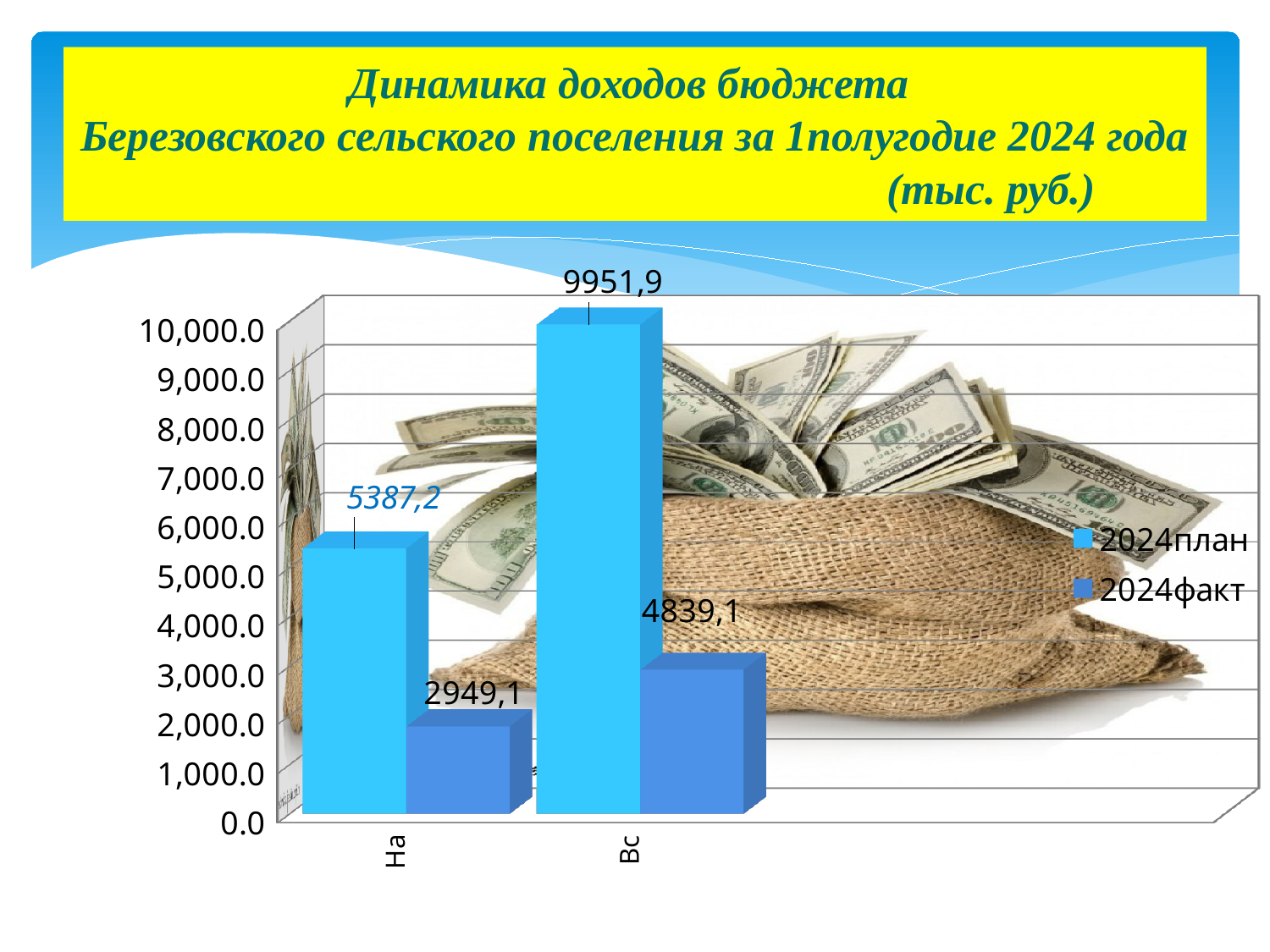
What is the 2024факт value for the first category (labelled "На")? 2949,1 What are the two series named in the legend? 2024план and 2024факт How many series does the legend list? 2 What is the 2024план value for the second category (labelled "Вс")? 9951,9 How many categories are shown on the x axis? 2 Which bar has the highest value on the chart? 2024план for "Вс" What is the difference between the 2024план and 2024факт values for the second category (labelled "Вс")? 5112,8 What is the 2024факт value for the second category (labelled "Вс")? 4839,1 Which bar has the lowest value on the chart? 2024факт for "На" Which is larger: the 2024факт value for "Вс" or the 2024план value for "На"? 2024план value for "На" What kind of chart is shown on the slide? bar chart What is the 2024план value for the first category (labelled "На")? 5387,2